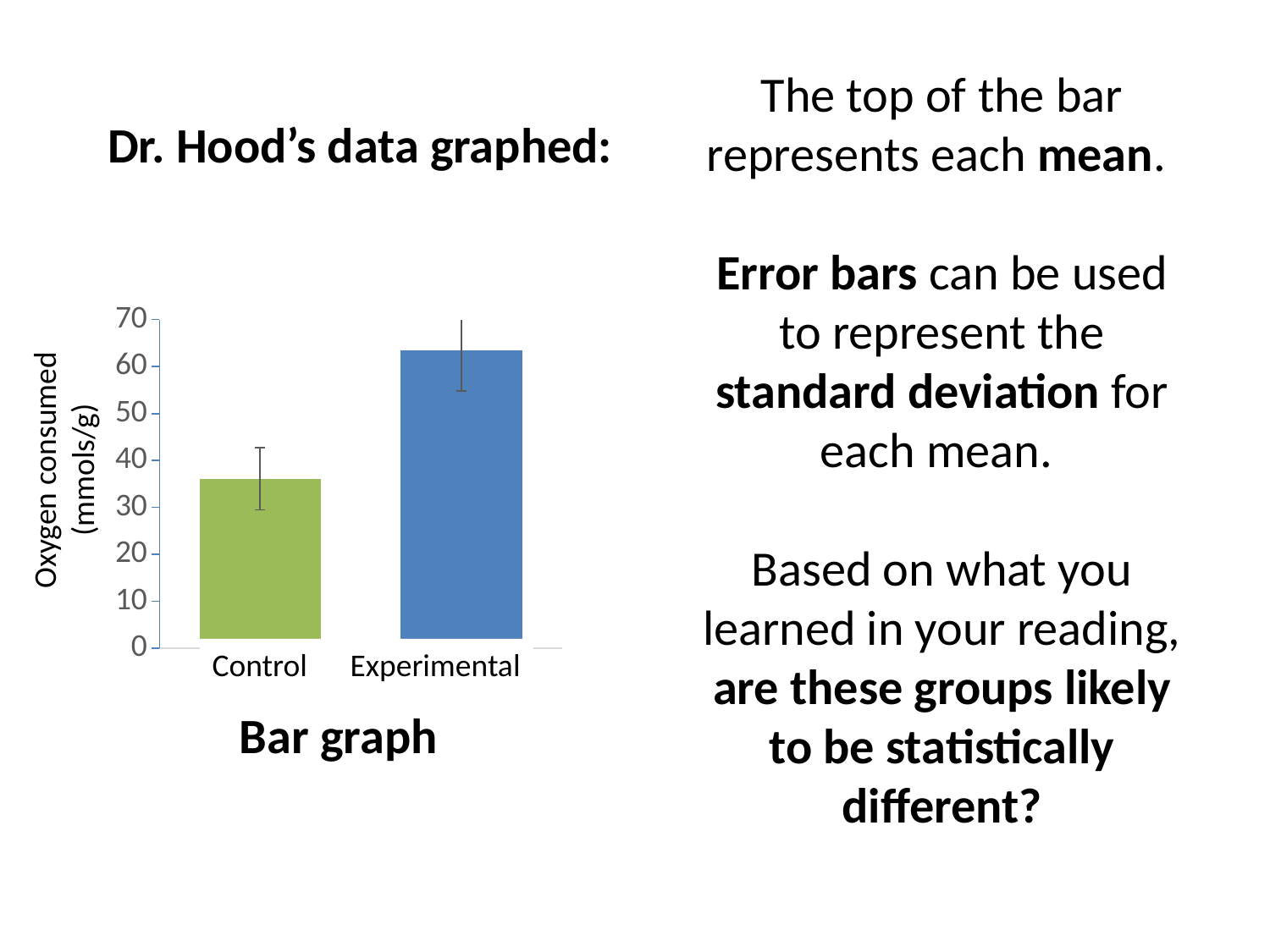
Which category has the lowest oxygen consumed value? Control What kind of chart is shown on the slide? bar chart What is the label on the vertical axis of the chart? Oxygen consumed (mmols/g) Is the value for Control greater or less than 30? greater Which is larger, the value for Control or the value for Experimental? Experimental Is the value for Experimental greater or less than 50? greater What colour is the Experimental bar? blue Is the value for Experimental greater or less than 70? less How many categories are plotted on the bar chart? 2 Which category has the highest oxygen consumed value? Experimental